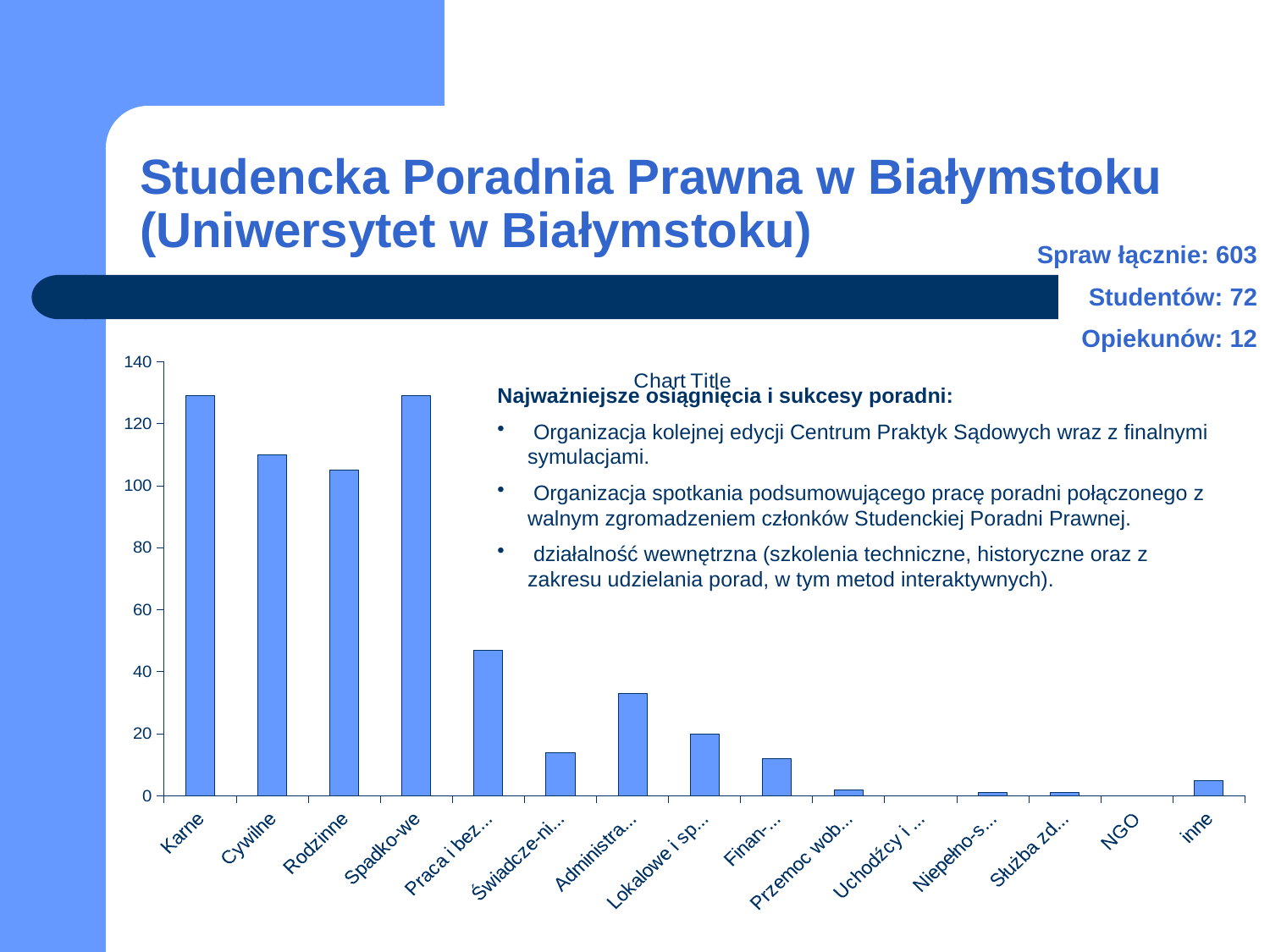
What is the title shown on the chart? Chart Title How many categories are shown on the x axis of the chart? 15 What kind of chart is shown on the slide? bar chart Is the value for Administra... greater or less than 20? greater Is the value for Rodzinne greater or less than 120? less Which has a larger value, Karne or Cywilne? Karne Do the values generally rise or fall moving from left to right along the x axis? fall Is the value for Praca i bez... greater or less than 60? less Which has a larger value, Praca i bez... or Administra...? Praca i bez...